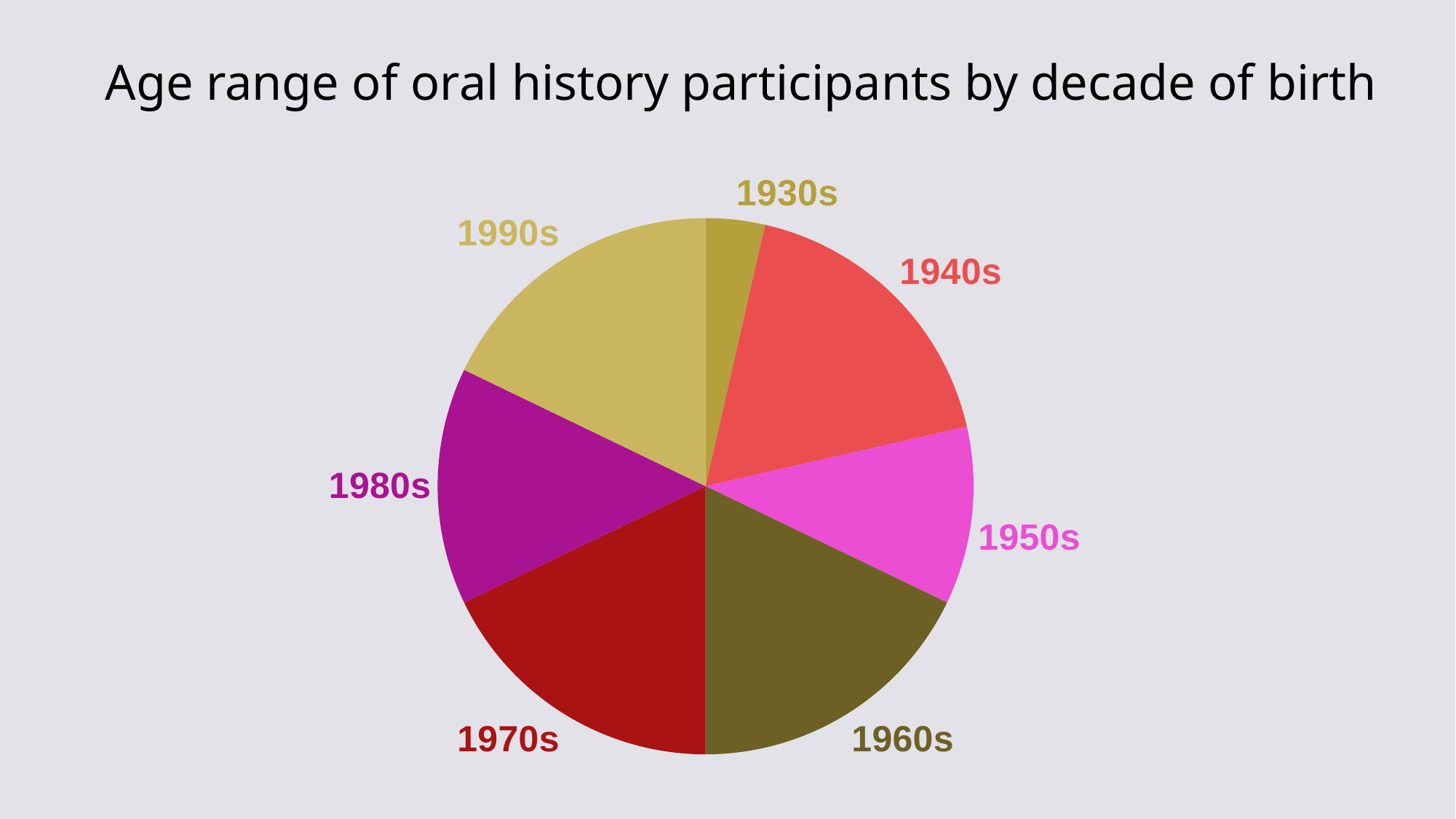
Which slice is larger, 1970s or 1980s? 1970s How many slices does the pie chart have? 7 Which slice is larger, 1950s or 1980s? 1980s What kind of chart is shown on the slide? Pie chart Which slice is larger, 1930s or 1940s? 1940s Which decade is represented by the purple slice? 1980s What is the title of the chart? Age range of oral history participants by decade of birth Which decade of birth has the smallest slice of the pie? 1930s